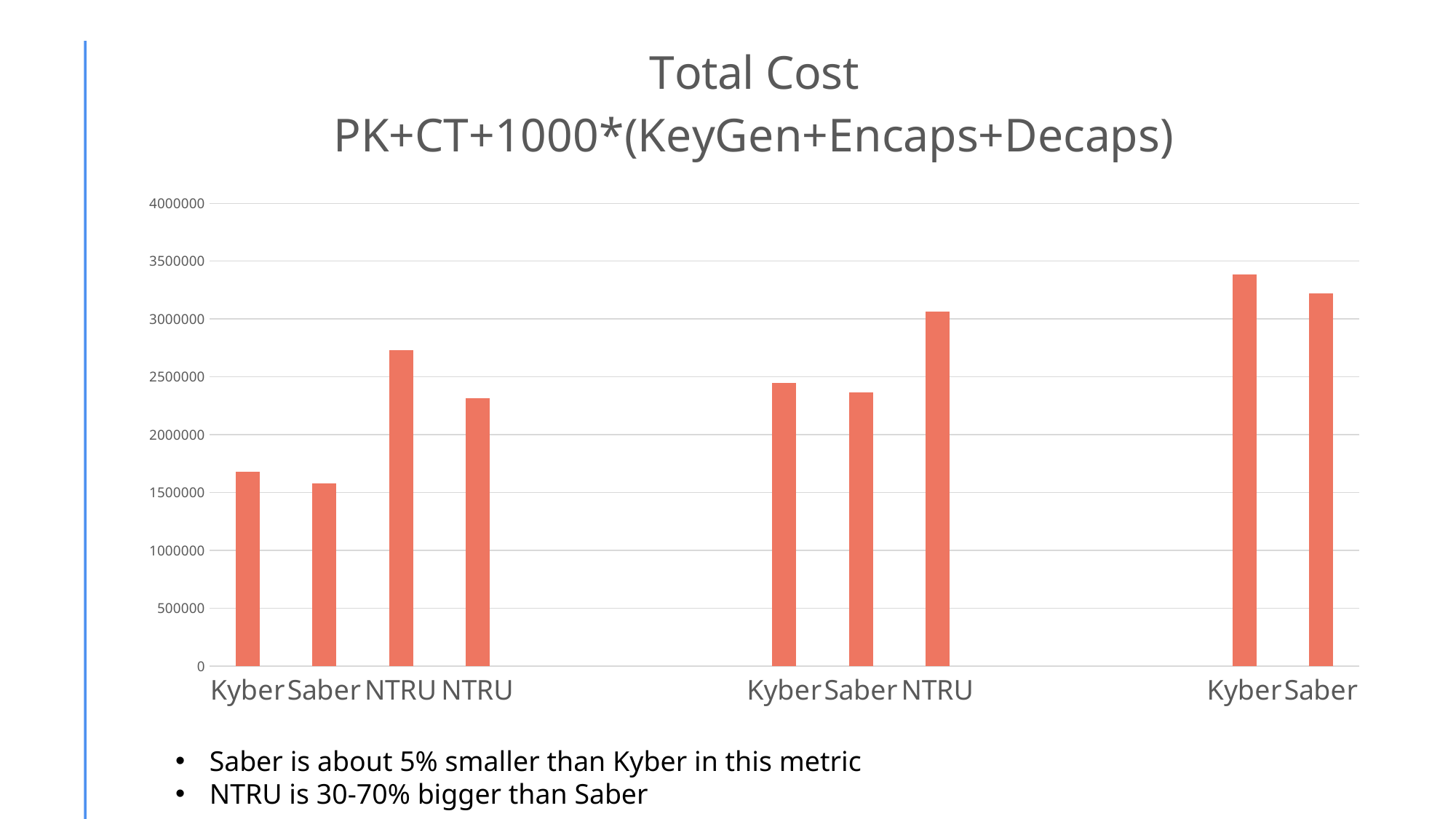
In the middle group, which is larger, the Kyber bar or the Saber bar? Kyber Is the value for the NTRU bar in the middle group greater or less than 3000000? greater What kind of chart is shown on the slide? bar chart Which bar is the shortest in the chart? Saber in the leftmost group Is the value for the Saber bar in the rightmost group greater or less than 3000000? greater Is the value for the Kyber bar in the rightmost group greater or less than 3500000? less How many bars are plotted in the chart? 9 In the leftmost group, which of the two NTRU bars is taller, the first or the second? the first What is the title of the chart? Total Cost PK+CT+1000*(KeyGen+Encaps+Decaps) Which bar is the tallest in the chart? Kyber in the rightmost group